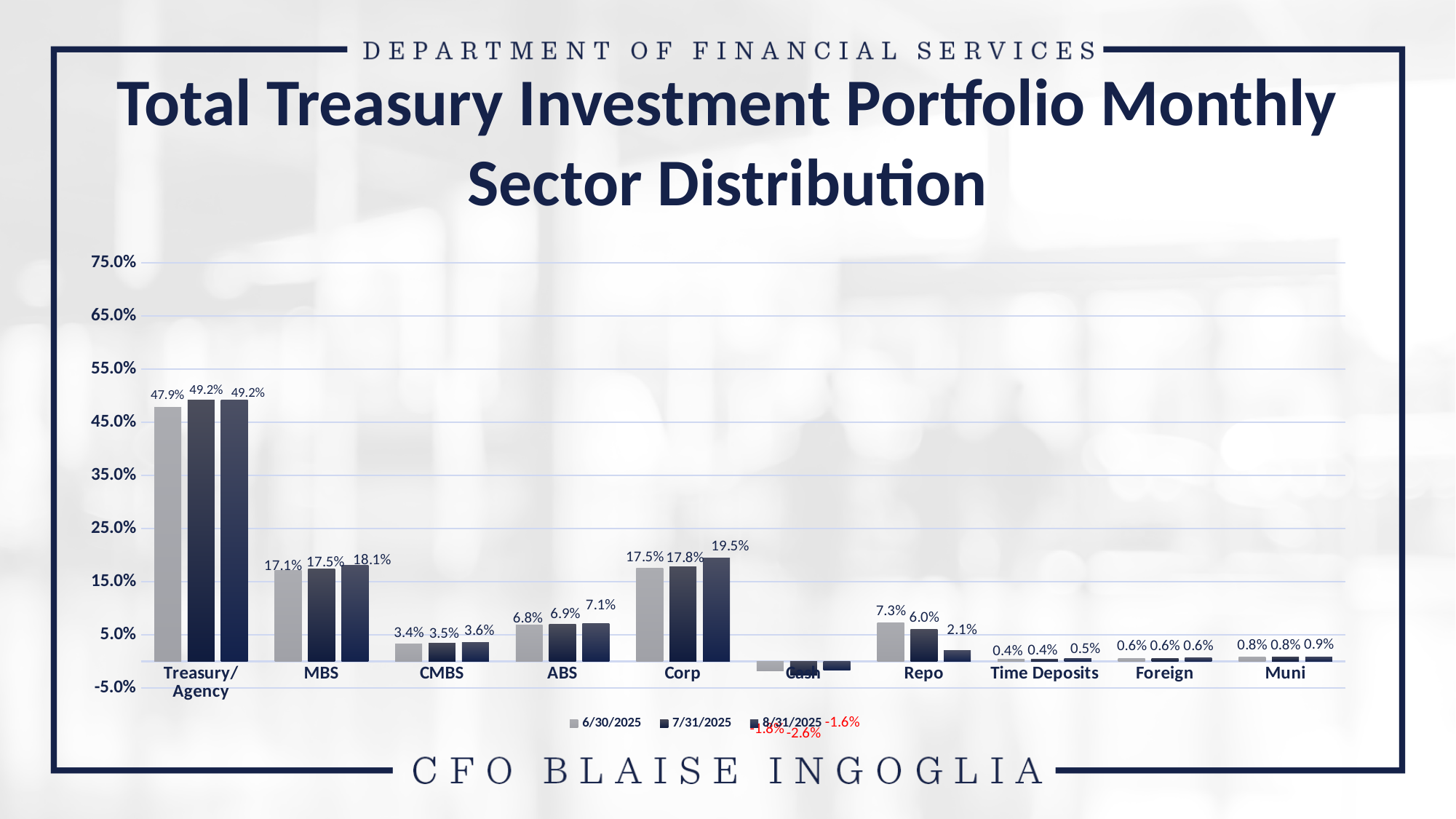
Do the Repo values rise or fall from 6/30/2025 to 8/31/2025? fall How many sector categories are shown on the x axis? 10 What kind of chart is shown on the slide? bar chart How many series does the legend list? 3 What is the difference between the 6/30/2025 and 8/31/2025 values for Repo? 5.2 percentage points In the 8/31/2025 series, which is larger: Corp or MBS? Corp Which sector has the highest value in the 8/31/2025 series? Treasury/Agency Is the 8/31/2025 value for Treasury/Agency greater or less than 45.0%? greater Which sector has the lowest value in the 8/31/2025 series? Cash What is the value for Repo in the 7/31/2025 series? 6.0% What is the value for Corp in the 8/31/2025 series? 19.5% What is the value for Treasury/Agency in the 6/30/2025 series? 47.9%